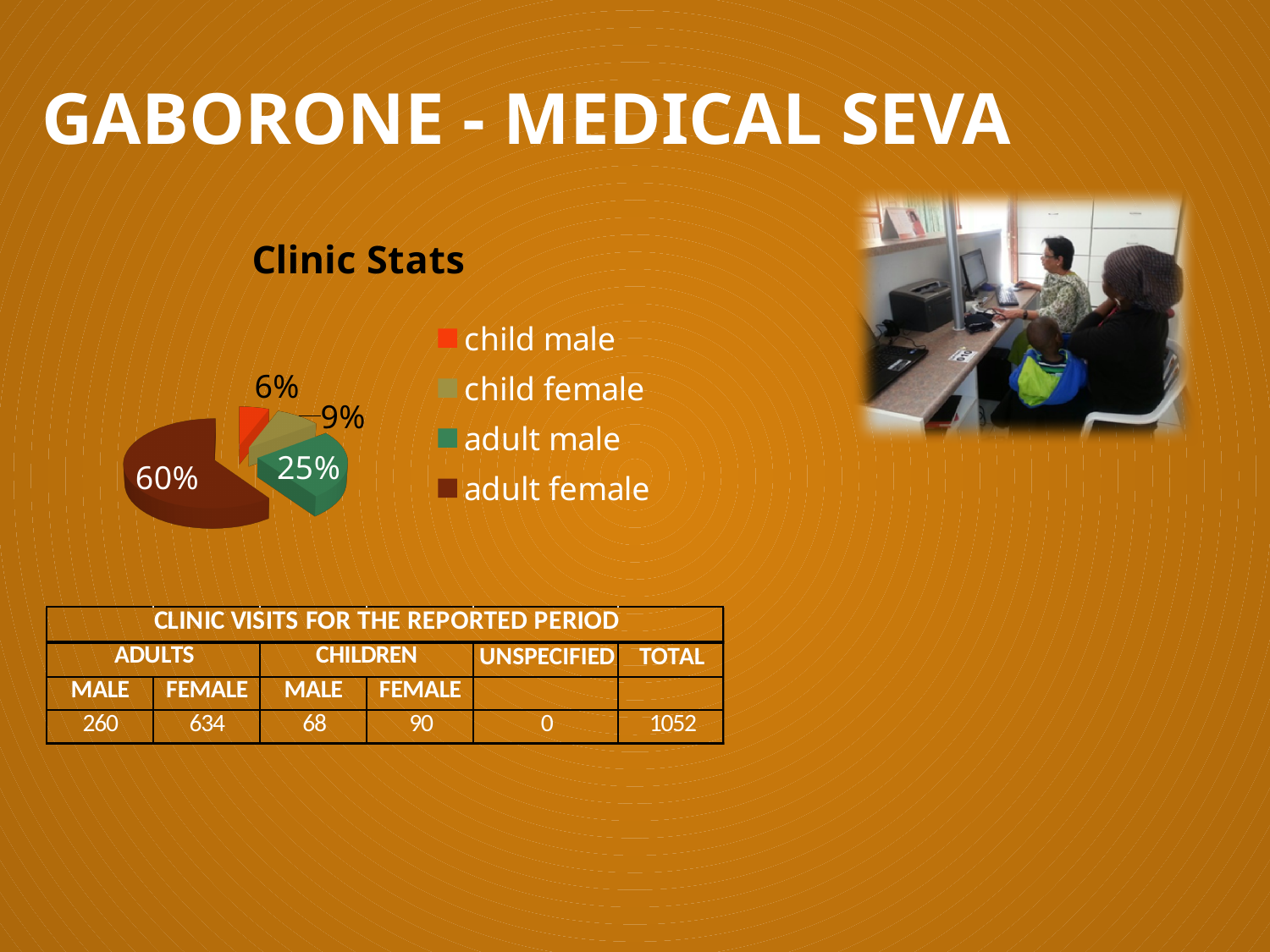
Which slice is larger in the pie chart, child female or child male? child female How many entries does the pie chart's legend list? 4 How many slices does the pie chart have? 4 Which category has the smallest slice in the pie chart? child male What is the title of the pie chart? Clinic Stats What is the difference in percentage points between the adult female and adult male slices? 35 Which category has the largest slice in the pie chart? adult female What share of the pie chart does adult male represent? 25% What share of the pie chart does child male represent? 6% What share of the pie chart does adult female represent? 60% What type of chart is shown under the title "Clinic Stats"? pie chart